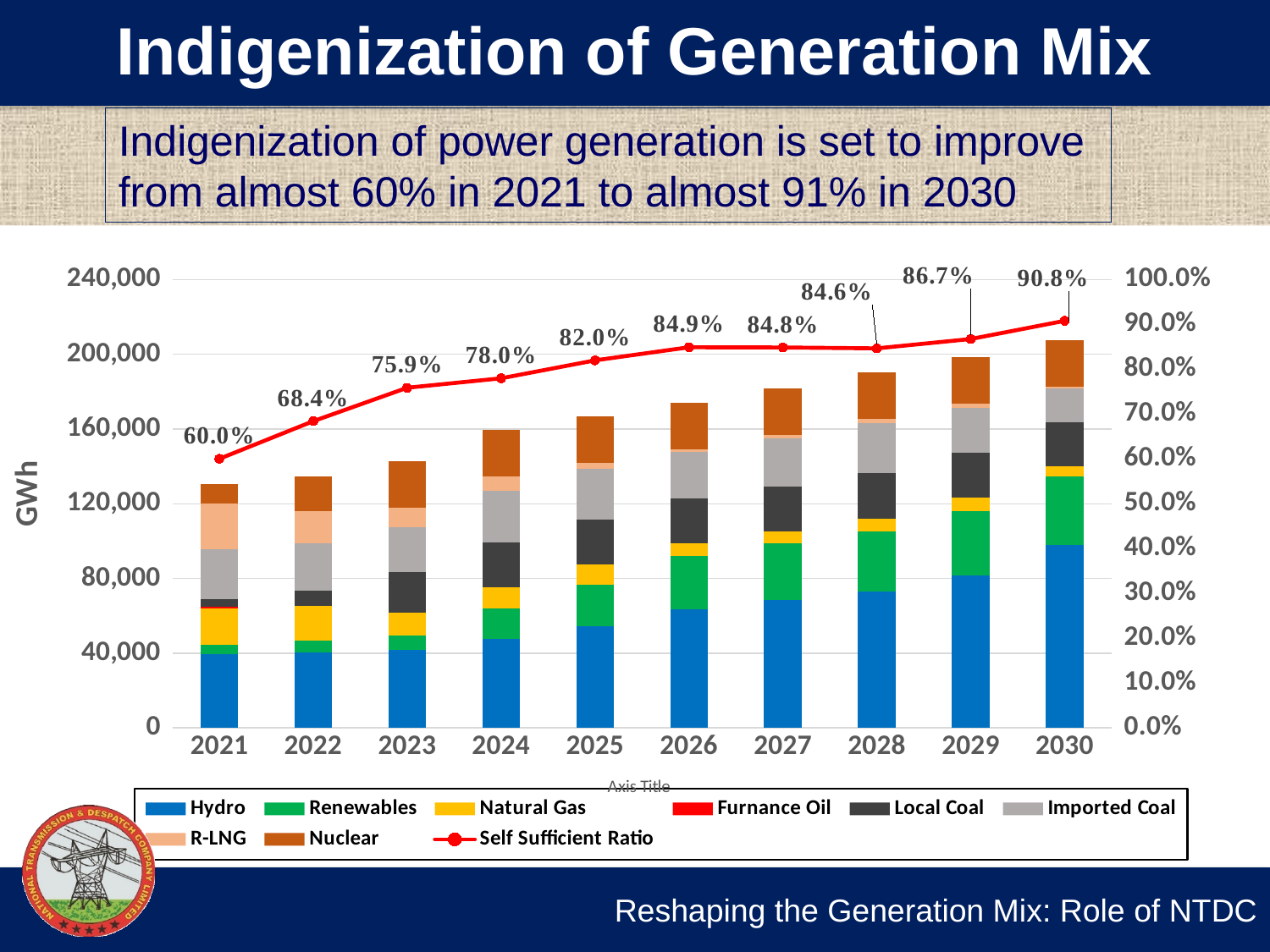
Which year has the higher Self Sufficient Ratio, 2026 or 2027? 2026 How many series does the legend list? 9 In which year is the Self Sufficient Ratio lowest? 2021 What is the Self Sufficient Ratio for 2025? 82.0% Is the total generation (stacked bar) for 2021 greater or less than 160,000 GWh? less By how many percentage points does the Self Sufficient Ratio increase from 2021 to 2030? 30.8 What is the Self Sufficient Ratio for 2030? 90.8% How many years are shown on the x axis? 10 What is the Self Sufficient Ratio for 2021? 60.0% What kind of chart is shown? Stacked bar chart with a line In which year is the Self Sufficient Ratio highest? 2030 What is the Self Sufficient Ratio for 2028? 84.6%